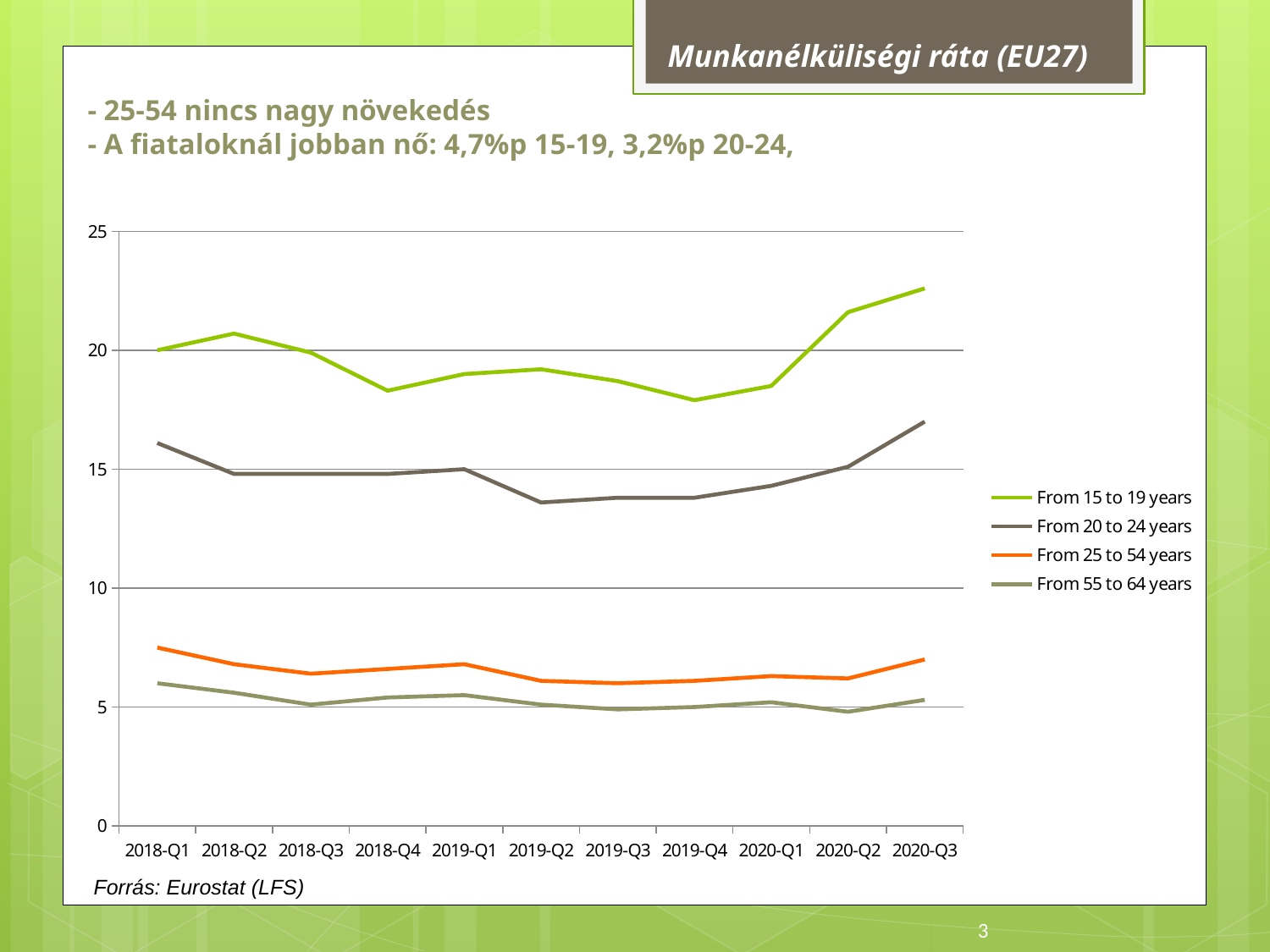
Is the value for 'From 15 to 19 years' in 2020-Q3 greater or less than 20? greater Is the value for 'From 25 to 54 years' in 2018-Q1 greater or less than 5? greater How many quarters are plotted along the x axis? 11 What is the title of the chart? Munkanélküliségi ráta (EU27) Which age group has the lowest unemployment rate across the whole period? From 55 to 64 years Which age group has the highest unemployment rate in 2020-Q3? From 15 to 19 years How many series does the legend list? 4 What kind of chart is shown on the slide? Line chart Which is larger in 2018-Q1: the value for 'From 15 to 19 years' or 'From 20 to 24 years'? From 15 to 19 years Is the value for 'From 20 to 24 years' in 2019-Q2 greater or less than 15? less Does the 'From 15 to 19 years' line rise or fall from 2020-Q1 to 2020-Q3? Rise